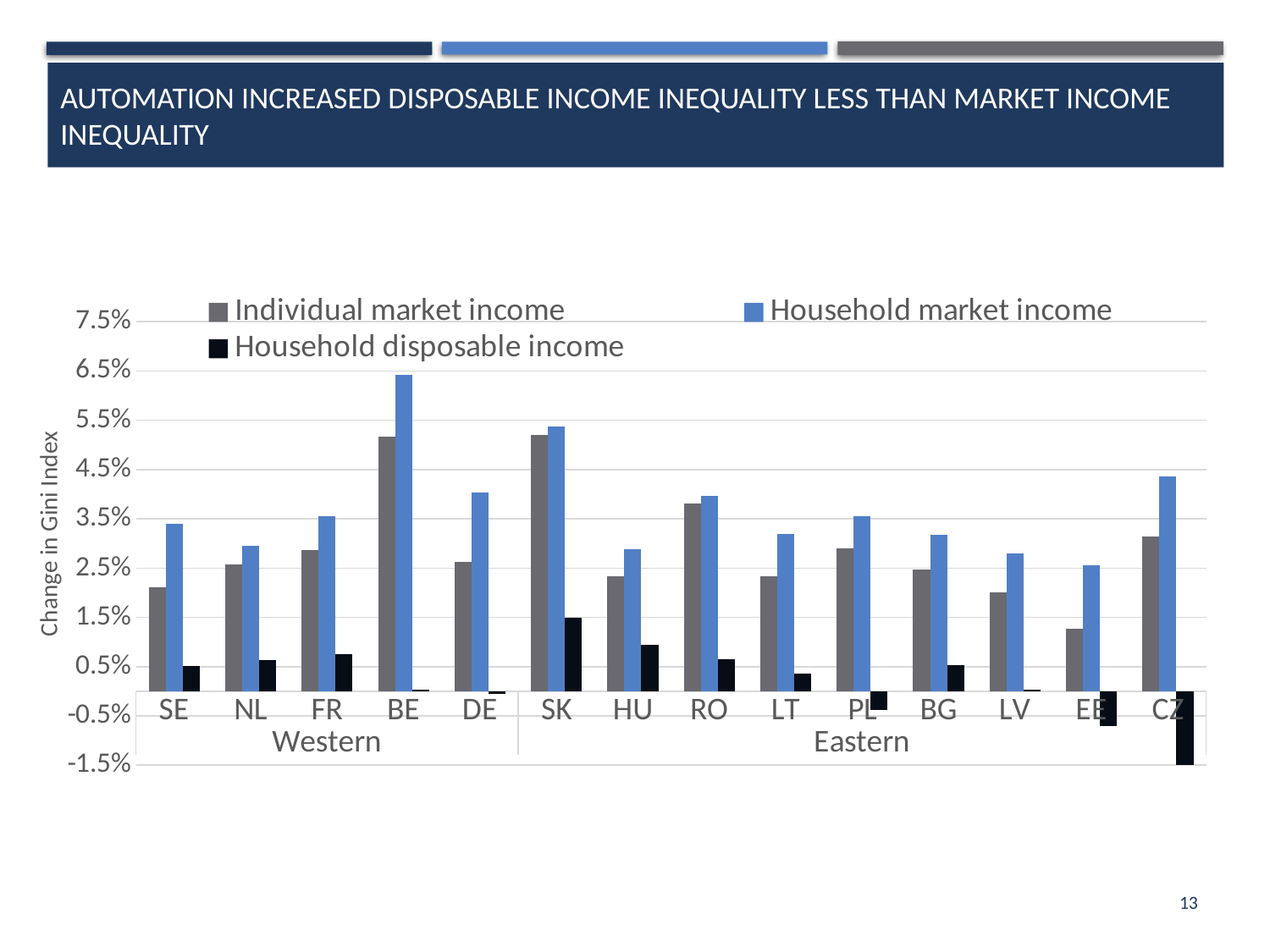
What is the label of the y axis? Change in Gini Index Is the Individual market income value for SE greater or less than 2.5%? less What kind of chart is shown on the slide? bar chart How many countries are shown on the x axis? 14 Is the Household disposable income value for CZ greater or less than -0.5%? less How many series does the legend list? 3 Which country has the highest Household disposable income value? SK Which country has the lowest Household disposable income value? CZ Which is larger, the Household disposable income value for SK or for HU? SK Is the Household market income value for BE greater or less than 5.5%? greater Which country has the highest Household market income value? BE Which is larger, the Individual market income value for HU or for RO? RO